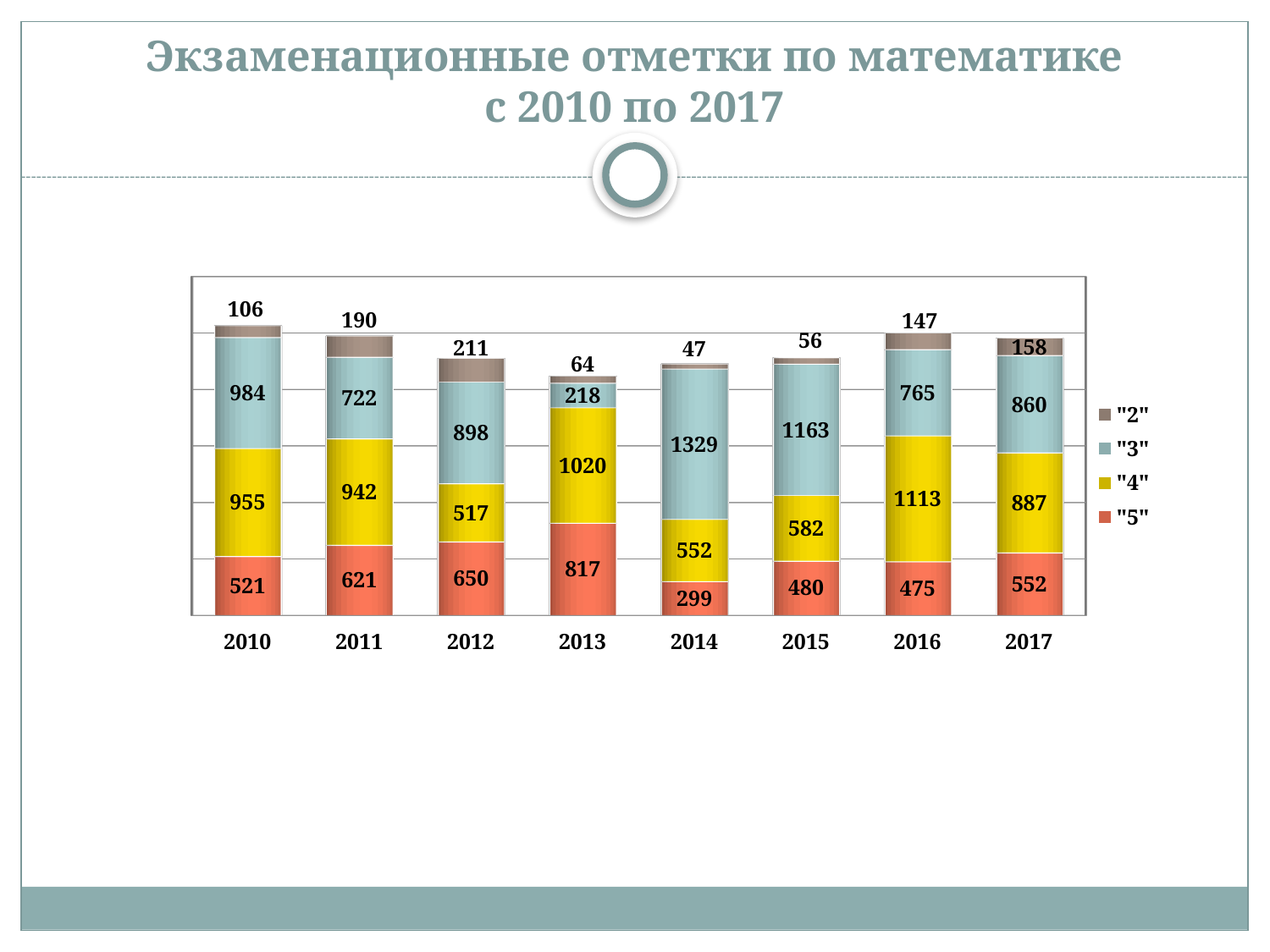
In which year is the value for "5" the highest? 2013 In which year is the value for "2" the lowest? 2014 In which year is the value for "4" the highest? 2016 What is the difference between the "3" values for 2014 and 2015? 166 What is the total of the stacked bar for 2013? 2119 What kind of chart is shown on the slide? Stacked bar chart Which is larger: the "4" value for 2013 or for 2016? 2016 How many series does the legend list? 4 What is the value for "2" in 2012? 211 How many years are shown on the x axis? 8 What is the value for "3" in 2014? 1329 What is the value for "5" in 2013? 817